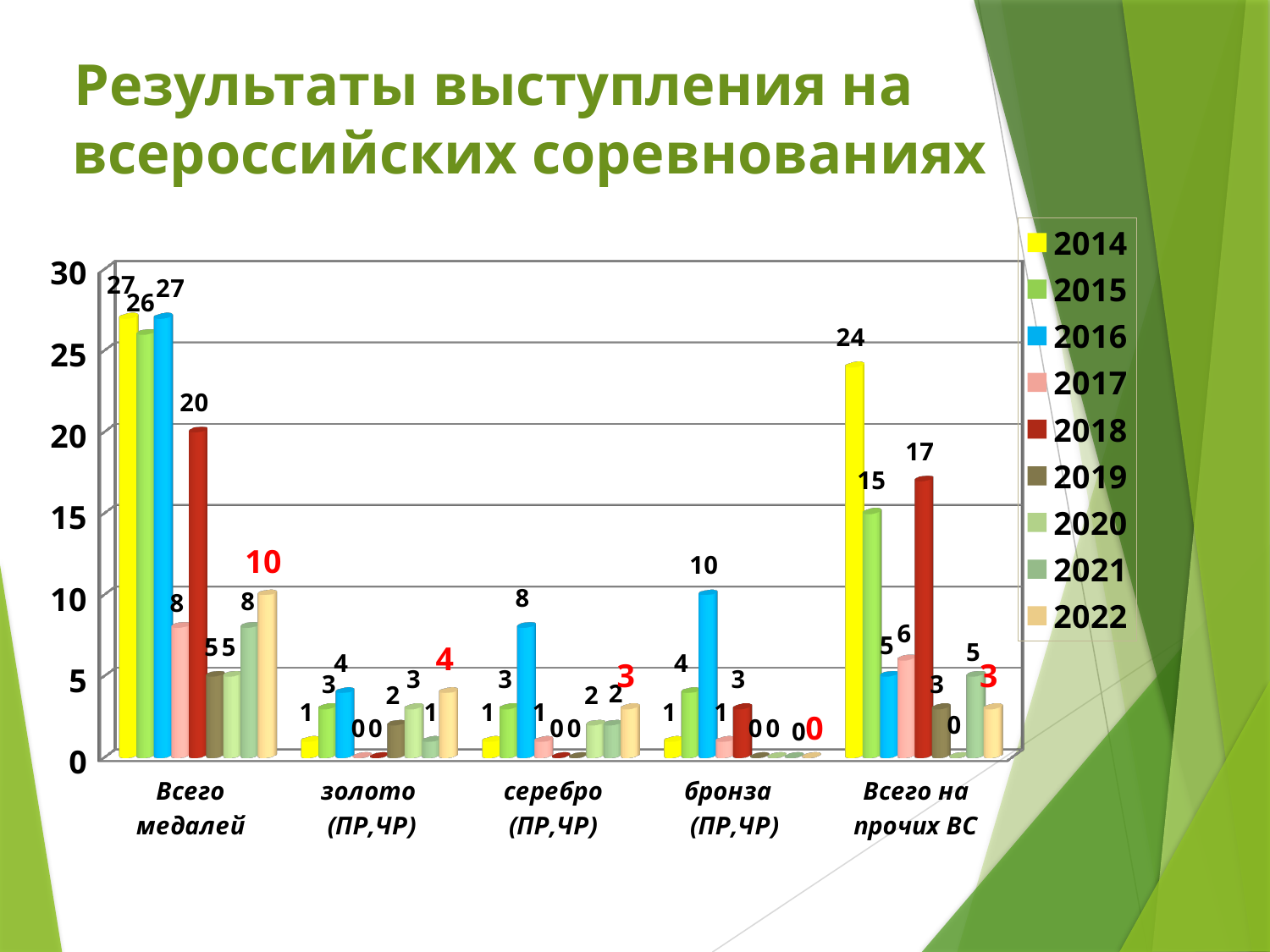
Which year has the lowest value in the "Всего на прочих ВС" category? 2020 What is the difference between the 2014 and 2018 values in the "Всего на прочих ВС" category? 7 What is the value for 2016 in the "бронза (ПР,ЧР)" category? 10 What is the value for 2022 in the "Всего медалей" category? 10 What is the title of the slide? Результаты выступления на всероссийских соревнованиях What is the value for 2018 in the "Всего медалей" category? 20 What kind of chart is shown on the slide? Bar chart How many series does the legend list? 9 Which year has the highest value in the "серебро (ПР,ЧР)" category? 2016 How many categories are shown on the x axis? 5 In the "золото (ПР,ЧР)" category, which is larger: the value for 2015 or the value for 2016? 2016 What is the value for 2014 in the "Всего на прочих ВС" category? 24